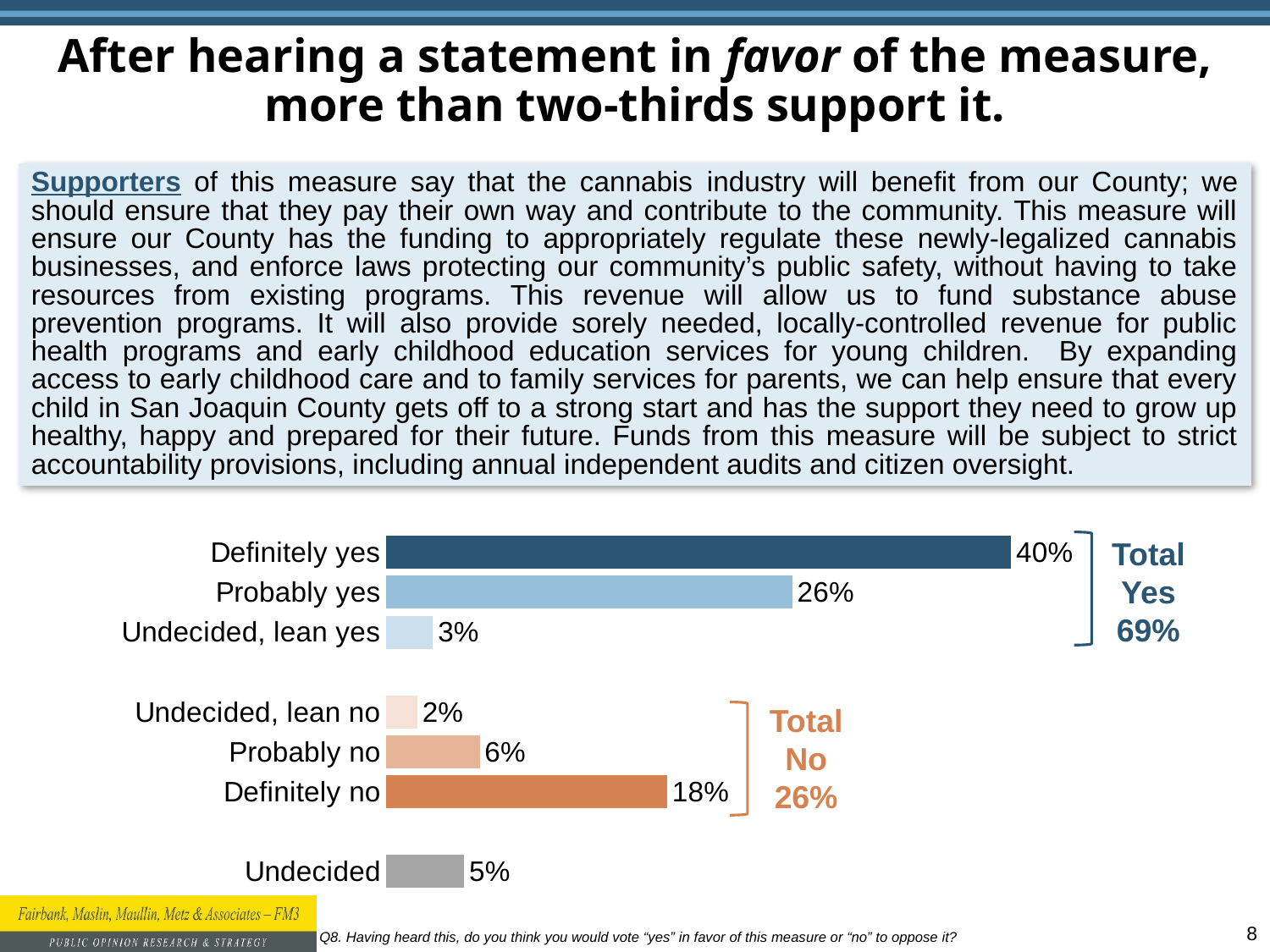
What percentage of respondents said "Definitely yes"? 40% What is the Total No percentage shown on the chart? 26% What is the difference between the Total Yes and Total No percentages? 43 percentage points What percentage of respondents said "Probably no"? 6% Which is larger, the percentage for "Probably yes" or for "Definitely no"? Probably yes What type of chart is shown on the slide? Bar chart What is the difference between the "Definitely yes" and "Definitely no" percentages? 22 percentage points How many response categories are shown in the chart? 7 Which response category has the highest percentage? Definitely yes What percentage of respondents were "Undecided"? 5% Which response category has the lowest percentage? Undecided, lean no What is the Total Yes percentage shown on the chart? 69%